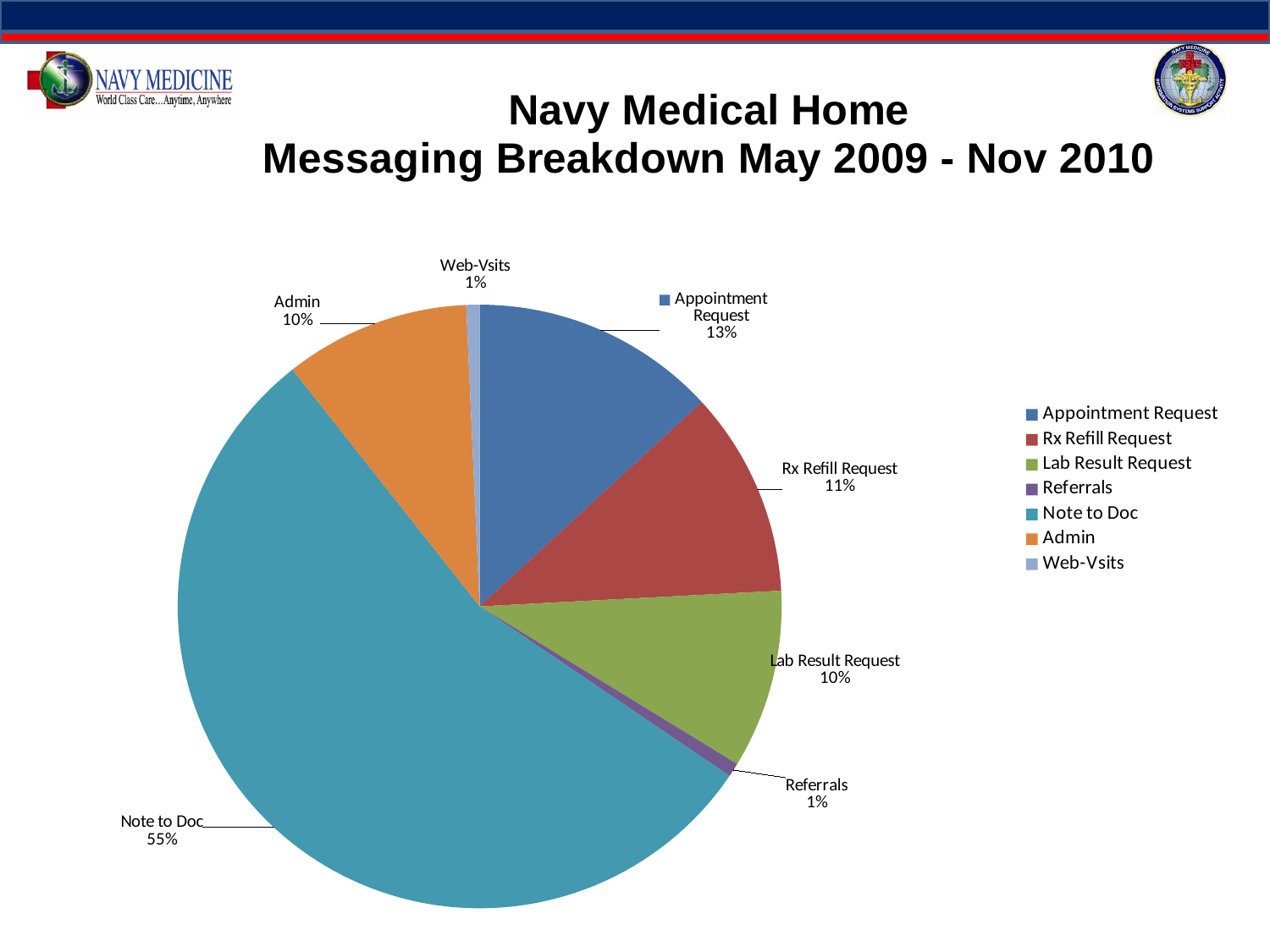
What percentage is shown for Rx Refill Request? 11% What colour is the Note to Doc slice? Teal What kind of chart is shown on the slide? Pie chart Which is larger, the Rx Refill Request slice or the Admin slice? Rx Refill Request What percentage is shown for Appointment Request? 13% What share of messages is Note to Doc? 55% Which category has the largest slice of the pie? Note to Doc How many categories does the legend list? 7 What is the difference in percentage points between Appointment Request and Lab Result Request? 3% What is the title of the slide? Navy Medical Home Messaging Breakdown May 2009 - Nov 2010 What is the combined share of Referrals and Web-Vsits? 2% What percentage is shown for Admin? 10%